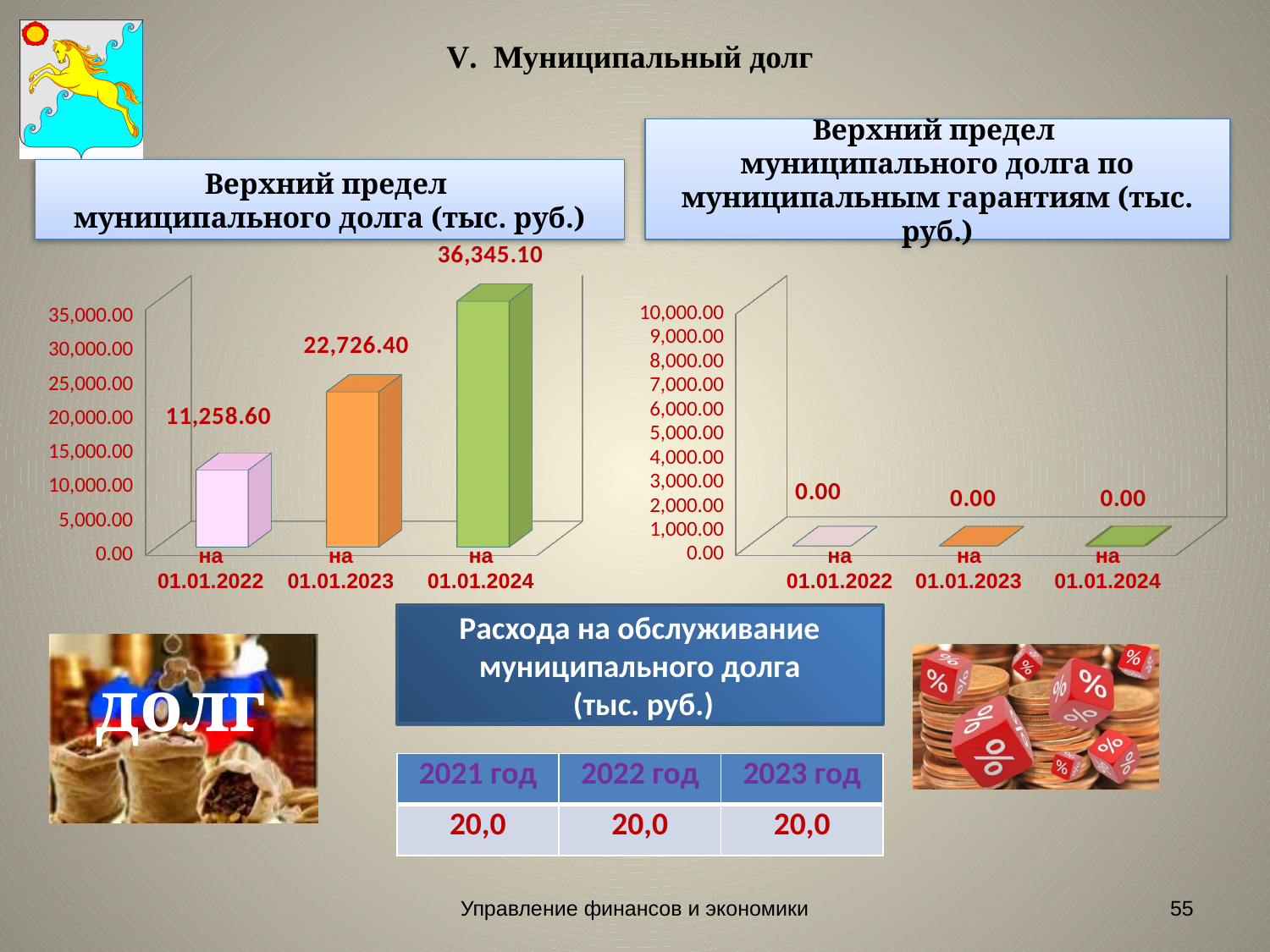
In the left chart 'Верхний предел муниципального долга (тыс. руб.)', do the values rise or fall from на 01.01.2022 to на 01.01.2024? rise In the right chart 'Верхний предел муниципального долга по муниципальным гарантиям (тыс. руб.)', what is the highest value shown on the vertical axis? 10,000.00 In the left chart 'Верхний предел муниципального долга (тыс. руб.)', which category has the lowest value? на 01.01.2022 In the left chart 'Верхний предел муниципального долга (тыс. руб.)', what is the difference between the values for на 01.01.2023 and на 01.01.2022? 11,467.80 What kind of chart is the left chart 'Верхний предел муниципального долга (тыс. руб.)'? bar chart In the left chart 'Верхний предел муниципального долга (тыс. руб.)', what is the value for на 01.01.2023? 22,726.40 In the right chart 'Верхний предел муниципального долга по муниципальным гарантиям (тыс. руб.)', what is the value for на 01.01.2023? 0.00 In the left chart 'Верхний предел муниципального долга (тыс. руб.)', what is the difference between the values for на 01.01.2024 and на 01.01.2022? 25,086.50 In the left chart 'Верхний предел муниципального долга (тыс. руб.)', how many categories are shown? 3 In the left chart 'Верхний предел муниципального долга (тыс. руб.)', what is the value for на 01.01.2024? 36,345.10 In the left chart 'Верхний предел муниципального долга (тыс. руб.)', which category has the highest value? на 01.01.2024 In the left chart 'Верхний предел муниципального долга (тыс. руб.)', what is the value for на 01.01.2022? 11,258.60